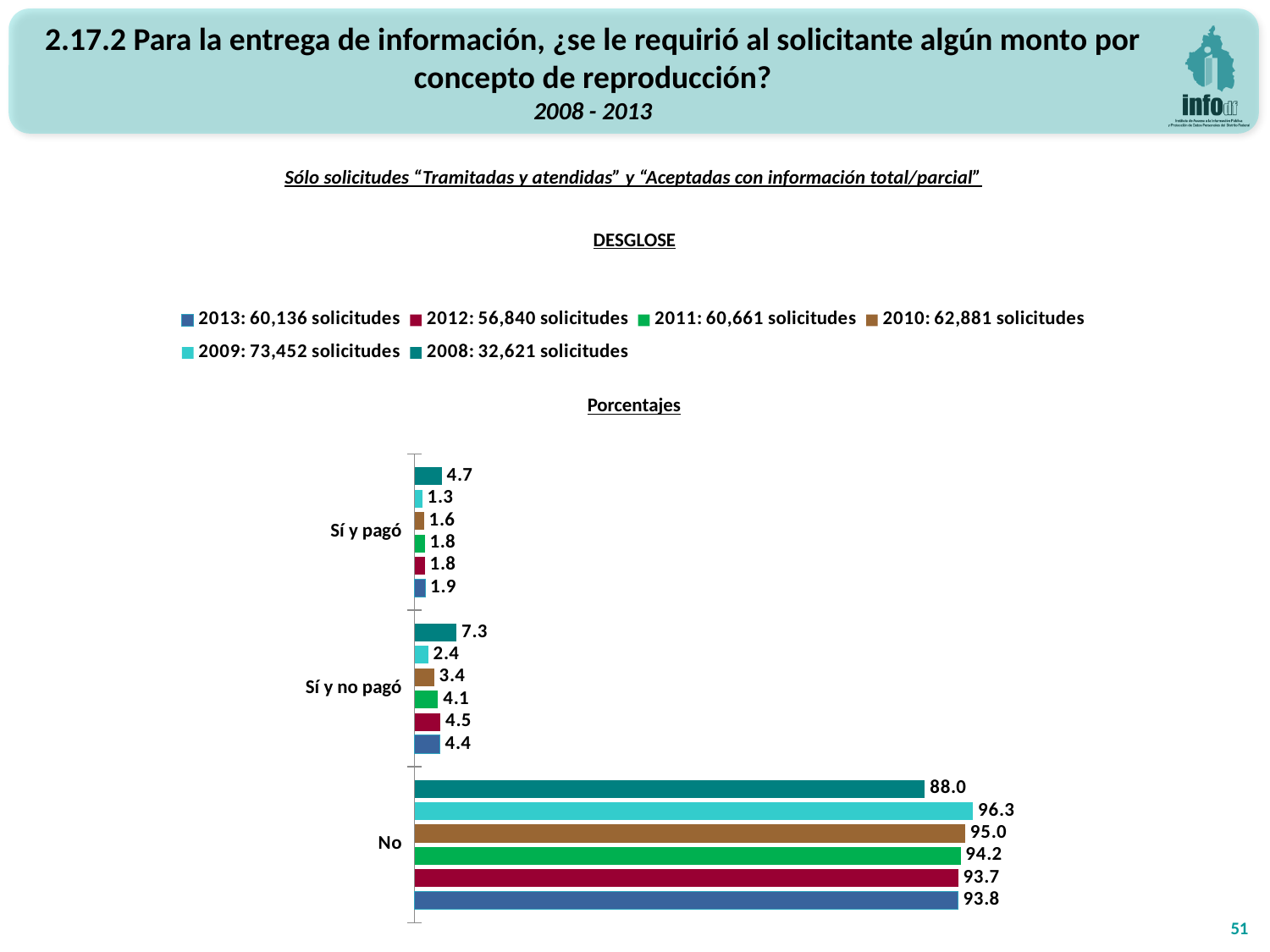
According to the legend, how many solicitudes were there in 2009? 73,452 What is the difference between the 2009 and 2008 values for "No"? 8.3 Which is larger for "Sí y no pagó": the 2008 value or the 2012 value? 2008 Which year has the lowest value for "Sí y pagó"? 2009 What is the value for "Sí y no pagó" in the 2010 series? 3.4 What is the value for "Sí y no pagó" in the 2013 series? 4.4 What kind of chart is shown on the slide? Bar chart Which year has the highest value for "No"? 2009 What is the value for "Sí y pagó" in the 2008 series? 4.7 How many series does the legend list? 6 How many categories are shown on the chart? 3 What is the value for "No" in the 2009 series? 96.3